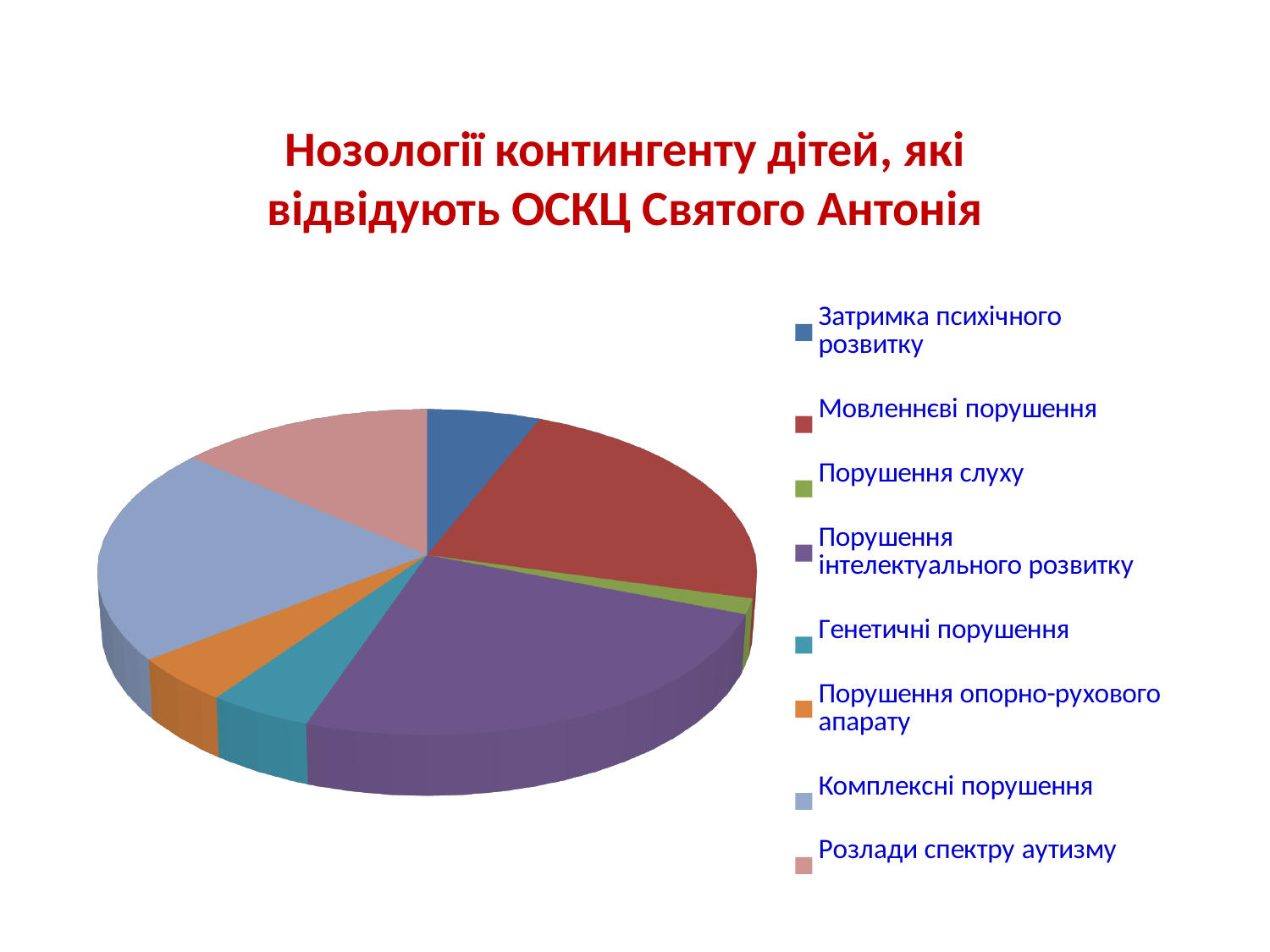
Which category has the largest slice of the pie? Порушення інтелектуального розвитку What is the title of the slide? Нозології контингенту дітей, які відвідують ОСКЦ Святого Антонія What kind of chart is shown on the slide? Pie chart Which category has the smallest slice of the pie? Порушення слуху Which slice is larger: Комплексні порушення or Розлади спектру аутизму? Комплексні порушення Which slice is larger: Порушення слуху or Генетичні порушення? Генетичні порушення How many categories does the pie chart have? 8 Which slice is larger: Порушення інтелектуального розвитку or Порушення опорно-рухового апарату? Порушення інтелектуального розвитку What colour is the slice for Порушення інтелектуального розвитку? Purple How many entries does the legend list? 8